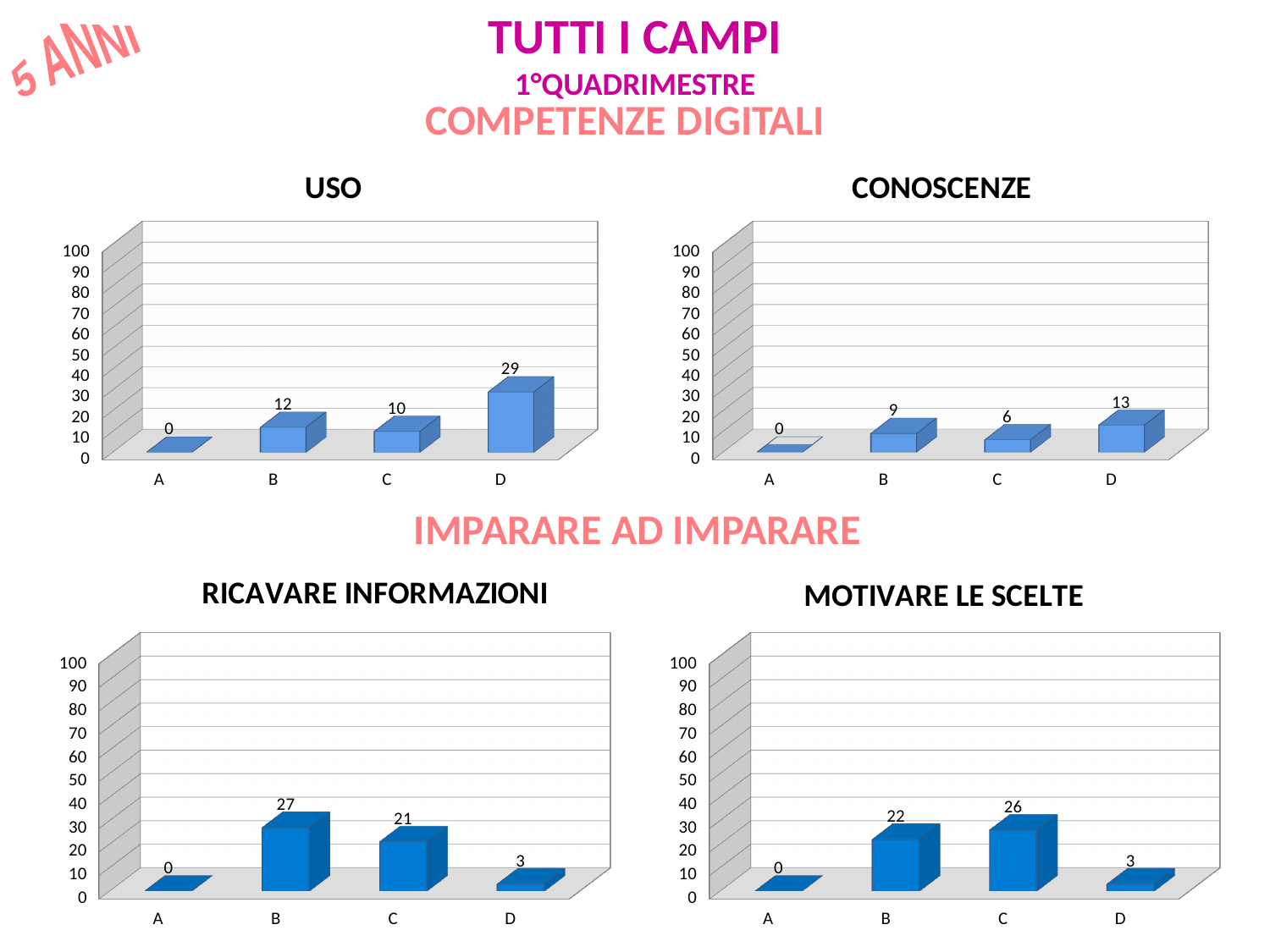
In the USO chart, which category has the lowest value? A In the USO chart, what is the value for category D? 29 In the MOTIVARE LE SCELTE chart, which category has the highest value? C How many categories are shown in the USO chart? 4 How many charts are shown on the slide? 4 In the MOTIVARE LE SCELTE chart, what is the value for category D? 3 In the MOTIVARE LE SCELTE chart, is the value for B greater or less than 10? greater In the RICAVARE INFORMAZIONI chart, what is the value for category C? 21 In the CONOSCENZE chart, which is larger, the value for B or the value for C? B What kind of chart is the CONOSCENZE chart? bar chart In the CONOSCENZE chart, what is the value for category B? 9 In the RICAVARE INFORMAZIONI chart, what is the difference between the values for B and C? 6